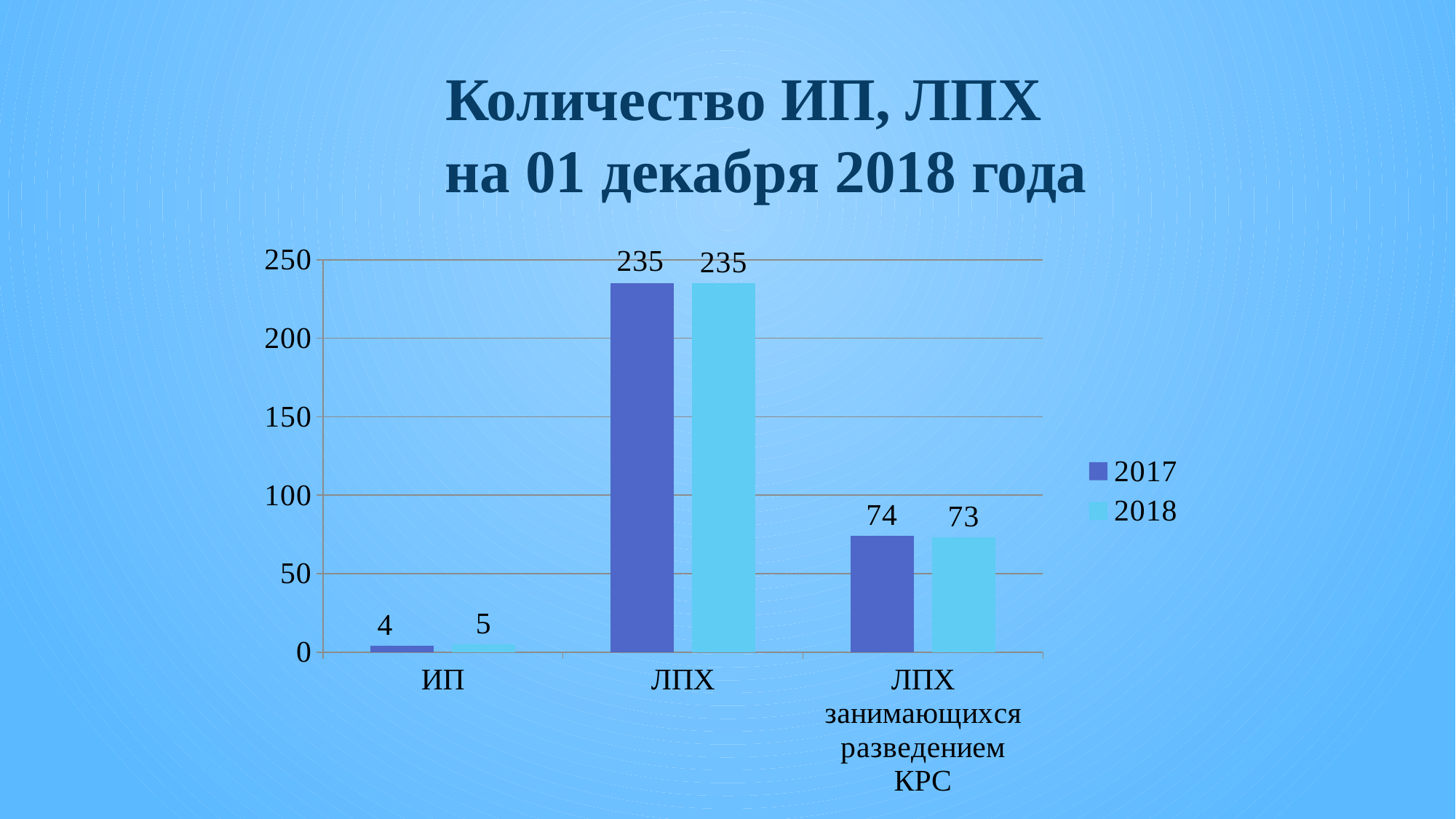
Which category has the lowest value in 2018? ИП What type of chart is shown on the slide? Bar chart Which category has the highest value in 2017? ЛПХ How many categories are shown on the x axis? 3 Which is larger for ИП: the 2017 value or the 2018 value? 2018 What is the value for ИП in 2018? 5 How many series does the legend list? 2 What is the value for ЛПХ in 2018? 235 What is the value for ИП in 2017? 4 What is the difference between the 2017 and 2018 values for ЛПХ занимающихся разведением КРС? 1 What is the value for ЛПХ занимающихся разведением КРС in 2017? 74 What is the difference between the ЛПХ and ИП values in 2017? 231